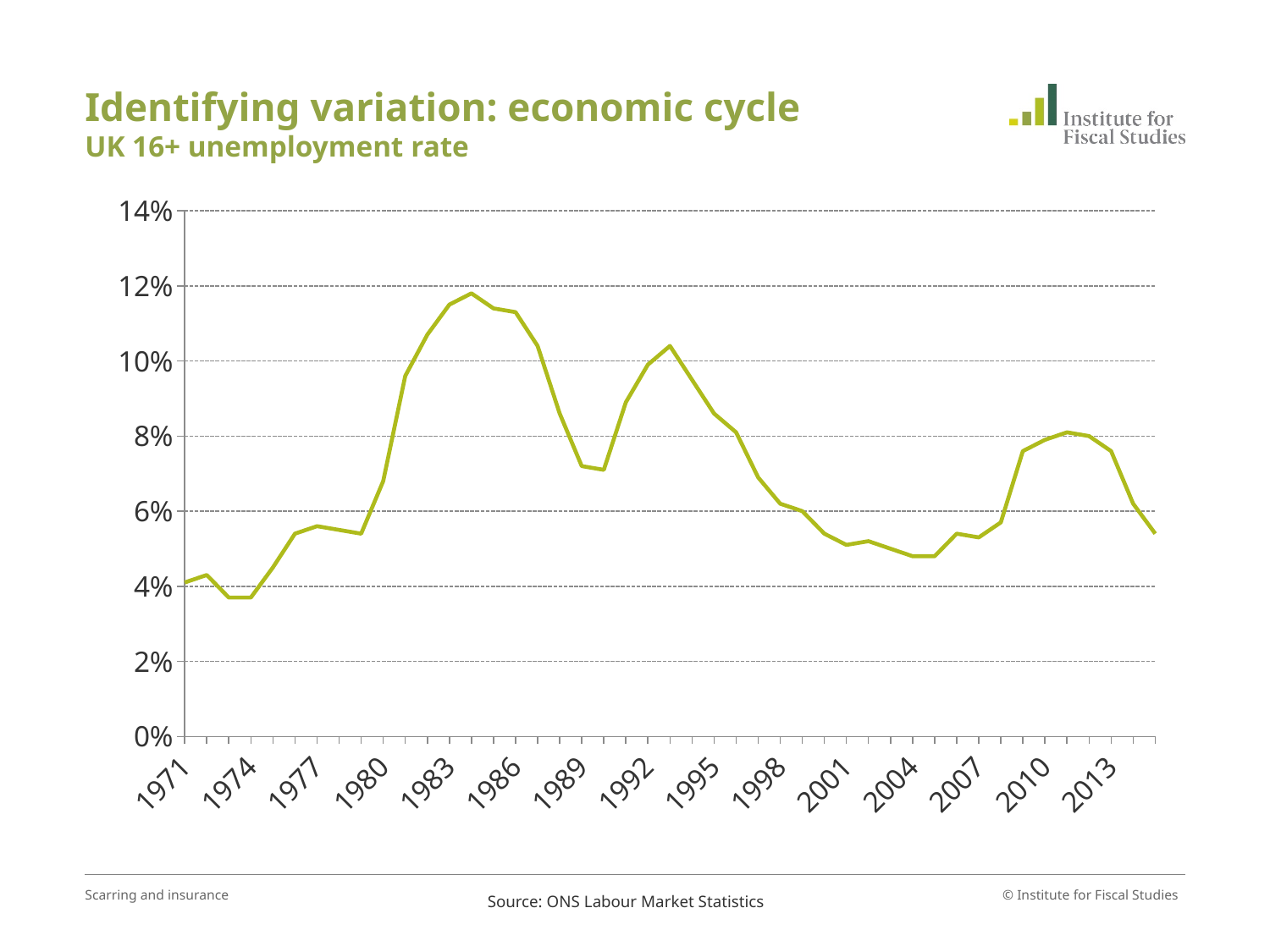
Is the unemployment rate for 1974 greater or less than 4%? less Is the unemployment rate for 1983 greater or less than 10%? greater Does the unemployment rate rise or fall between 2004 and 2010? rise What kind of chart is shown on the slide? line chart Is the unemployment rate for 1989 greater or less than 8%? less Which year has the higher unemployment rate, 1983 or 2013? 1983 Does the unemployment rate rise or fall between 1986 and 1989? fall Which year has the higher unemployment rate, 1974 or 1977? 1977 What is the subtitle describing the data plotted on the chart? UK 16+ unemployment rate What source is cited for the chart's data? ONS Labour Market Statistics